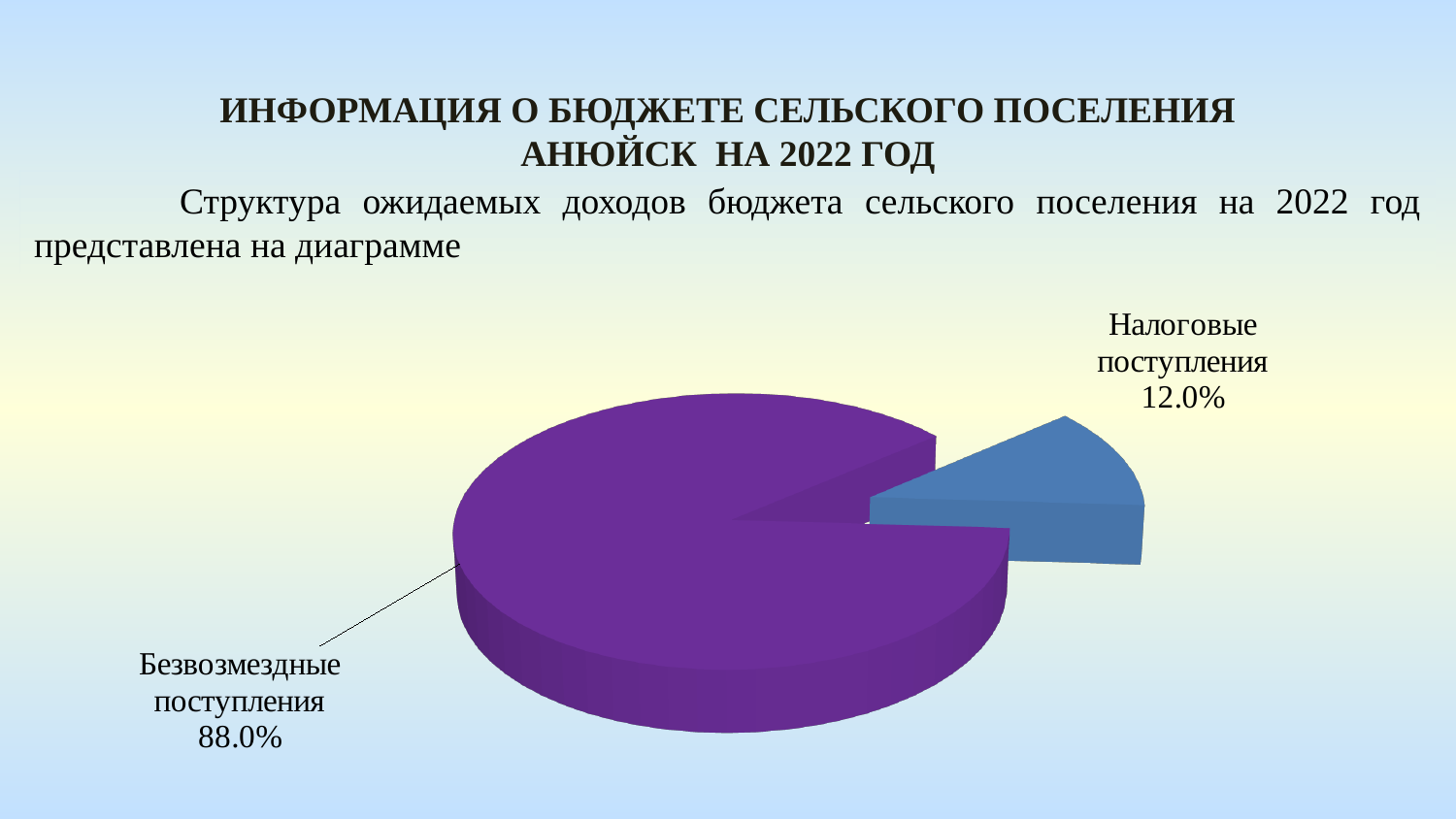
What is the total of the two slice percentages shown? 100.0% What share of the pie is labelled "Безвозмездные поступления"? 88.0% What share of the pie is labelled "Налоговые поступления"? 12.0% Which slice of the pie is the smallest? Налоговые поступления How many slices does the pie chart have? 2 What colour is the slice for "Налоговые поступления"? Blue Which slice of the pie is the largest? Безвозмездные поступления What is the difference in percentage points between "Безвозмездные поступления" and "Налоговые поступления"? 76.0 Which is larger: "Налоговые поступления" or "Безвозмездные поступления"? Безвозмездные поступления What colour is the slice for "Безвозмездные поступления"? Purple What kind of chart is shown on the slide? Pie chart